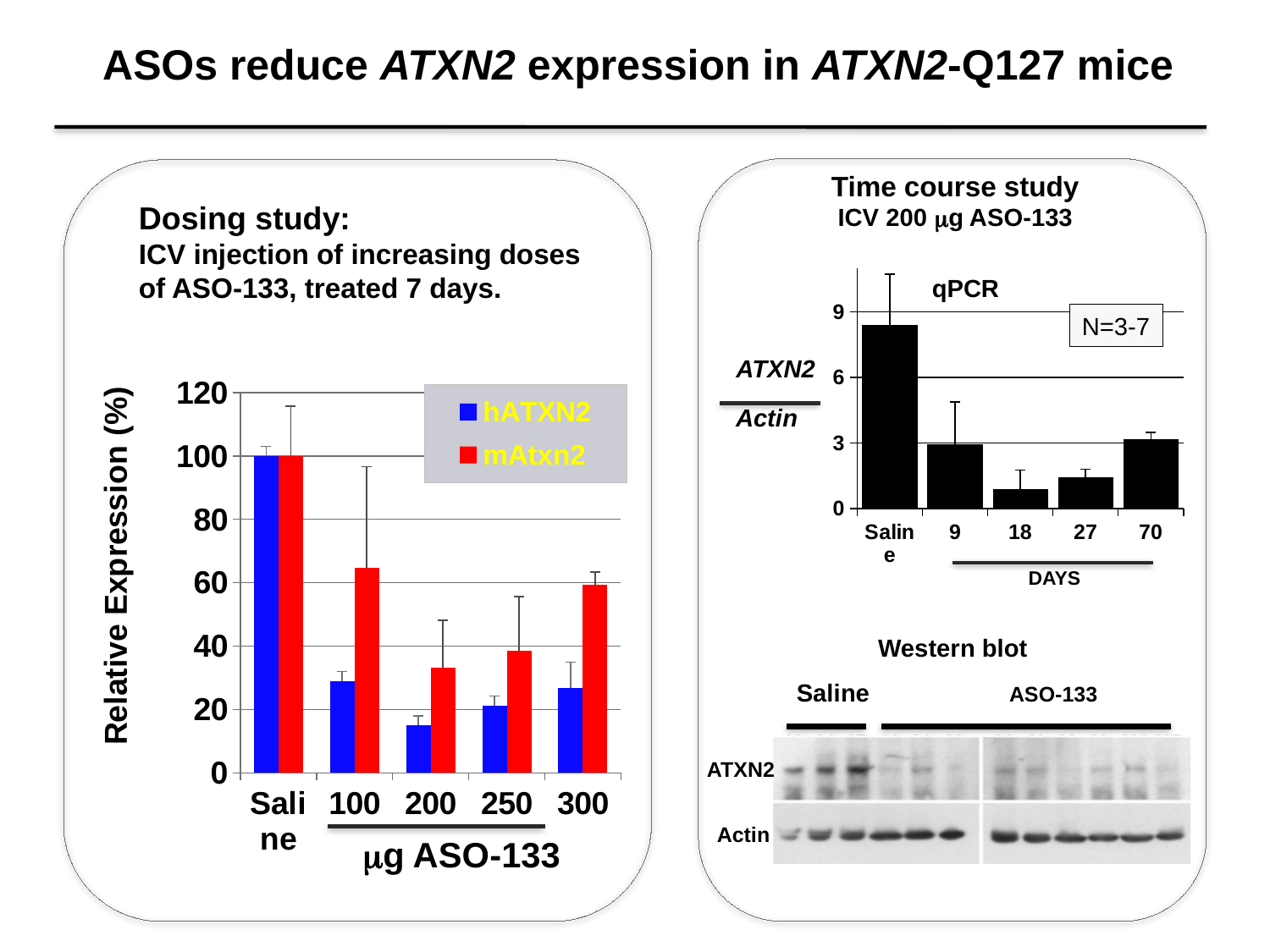
In the Dosing study chart, is the hATXN2 value for 100 µg ASO-133 greater or less than 40? less In the Dosing study chart, how many series does the legend list? 2 In the Dosing study chart, is the mAtxn2 value for 100 µg ASO-133 greater or less than 60? greater In the Dosing study chart, how many categories are shown on the x axis? 5 In the Dosing study chart, what are the two legend entries? hATXN2 and mAtxn2 In the Dosing study chart, what is the hATXN2 value for Saline? 100 In the Time course study qPCR chart, which category has the highest ATXN2/Actin value? Saline In the Dosing study chart, what kind of chart is used? bar chart In the Time course study qPCR chart, is the value for Saline greater or less than 6? greater In the Dosing study chart, at 100 µg ASO-133, which is larger, hATXN2 or mAtxn2? mAtxn2 In the Time course study qPCR chart, which is larger, the value at 9 days or at 18 days? 9 days In the Dosing study chart, at which dose is the hATXN2 value lowest? 200